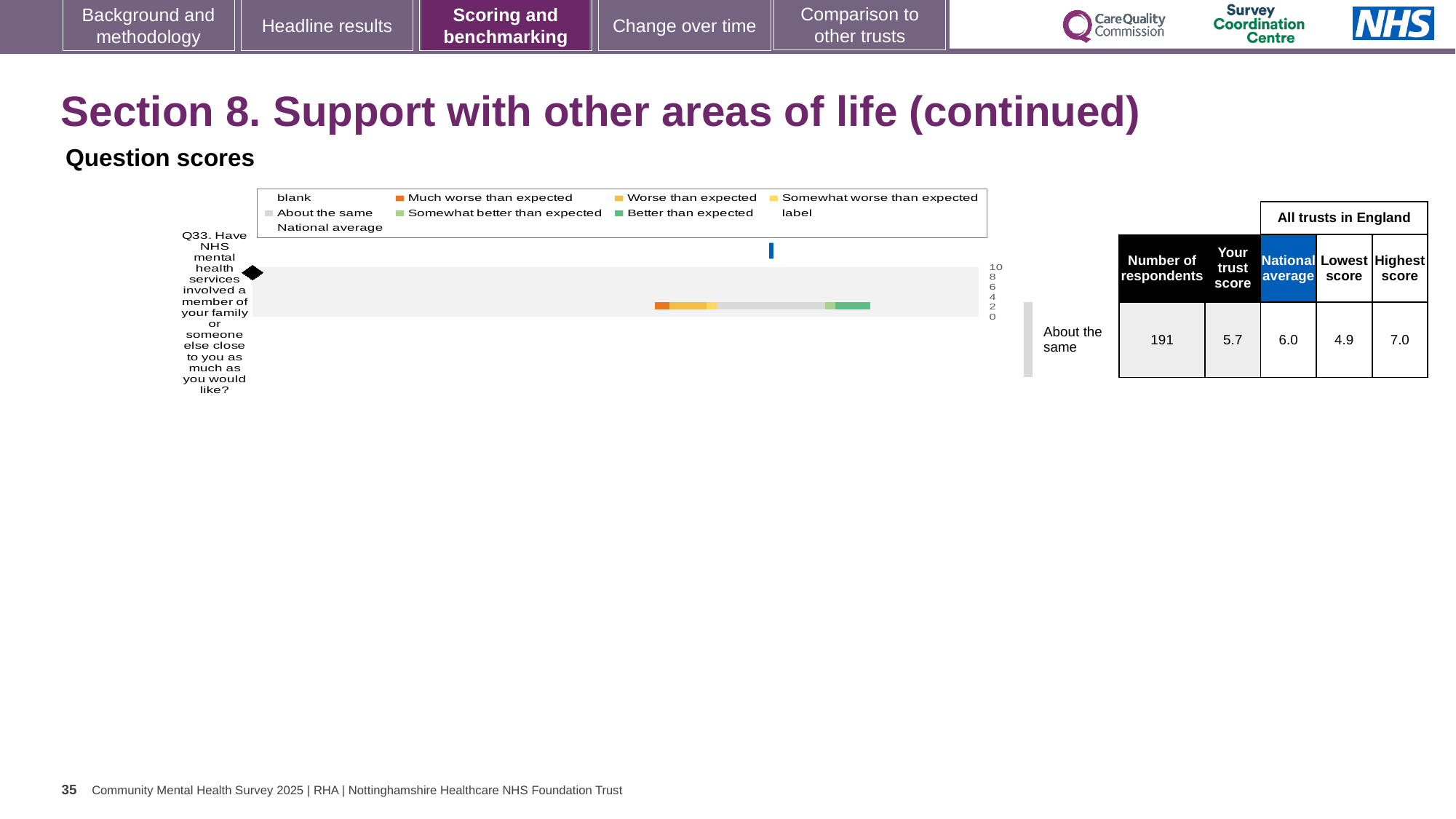
How many survey questions are plotted in the chart? 1 What is the highest value shown on the chart's score axis? 10 What is the number of respondents for Q33? 191 Which is larger for Q33, the trust's score or the national average? national average What is the lowest score among all trusts in England for Q33? 4.9 What is the difference between the highest score and the lowest score among all trusts in England for Q33? 2.1 What is the national average score for Q33? 6.0 What colour represents 'Much worse than expected' in the chart legend? orange How many entries does the chart legend list? 9 What kind of chart is shown on the slide? bar chart What is the trust's score for Q33? 5.7 Which question number is plotted in the chart? Q33